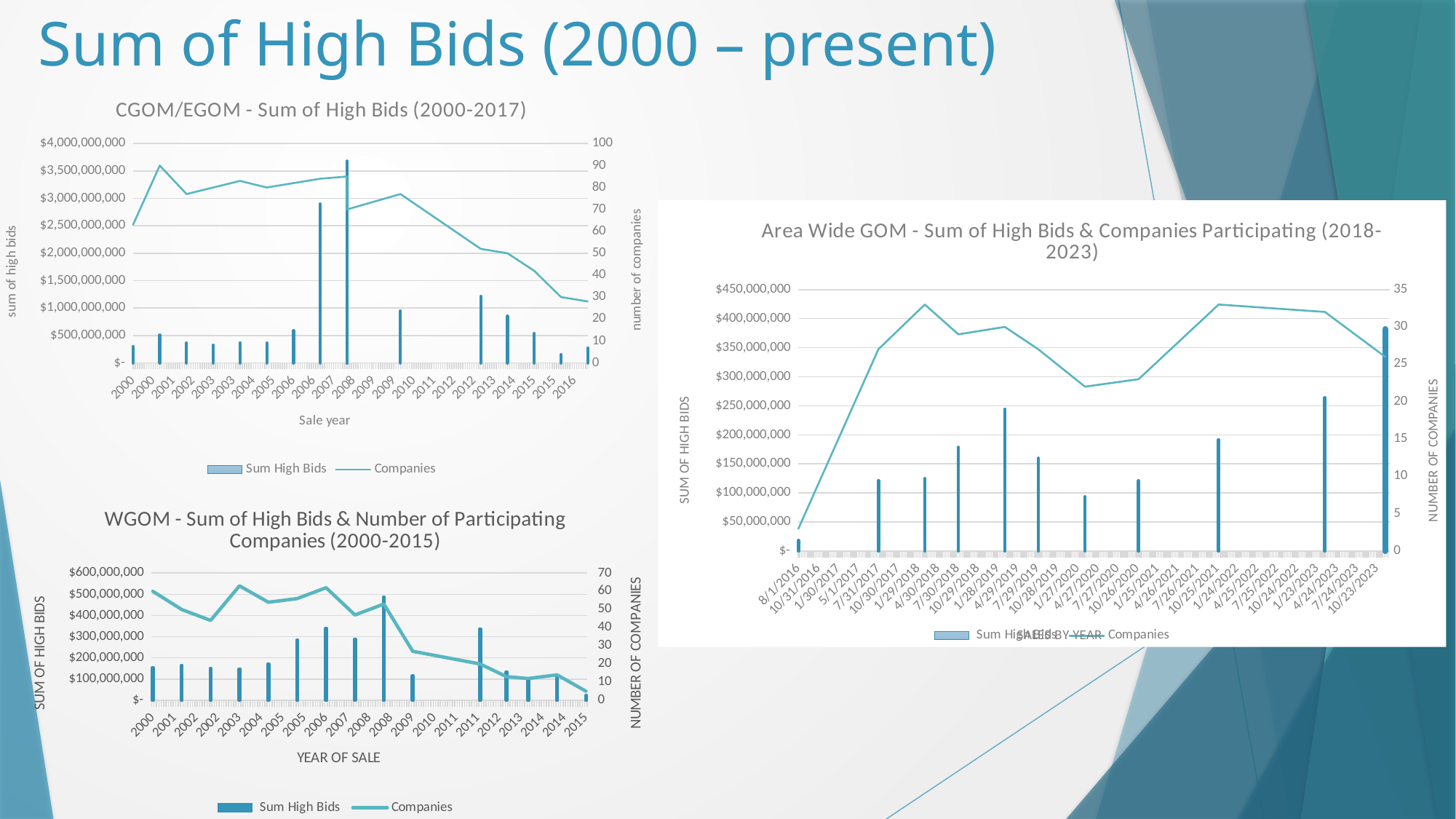
What is the x-axis title of the 'WGOM - Sum of High Bids & Number of Participating Companies (2000-2015)' chart? YEAR OF SALE How many series does the legend of the 'CGOM/EGOM - Sum of High Bids (2000-2017)' chart list? 2 In the 'WGOM - Sum of High Bids & Number of Participating Companies (2000-2015)' chart, which year has the highest Sum High Bids bar? 2008 What kind of chart is the 'CGOM/EGOM - Sum of High Bids (2000-2017)' chart? Combined bar and line chart In the 'WGOM - Sum of High Bids & Number of Participating Companies (2000-2015)' chart, is the Sum High Bids value for 2008 greater or less than $400,000,000? greater In the 'Area Wide GOM - Sum of High Bids & Companies Participating (2018-2023)' chart, is the Sum High Bids value for 4/29/2019 greater or less than $200,000,000? greater In the 'CGOM/EGOM - Sum of High Bids (2000-2017)' chart, is the Companies value for 2016 greater or less than 40? less In the 'Area Wide GOM - Sum of High Bids & Companies Participating (2018-2023)' chart, which sale date has the highest Sum High Bids bar? 10/23/2023 In the 'CGOM/EGOM - Sum of High Bids (2000-2017)' chart, does the Companies line generally rise or fall from 2010 to 2016? fall In the 'CGOM/EGOM - Sum of High Bids (2000-2017)' chart, which sale year has the highest Sum High Bids bar? 2008